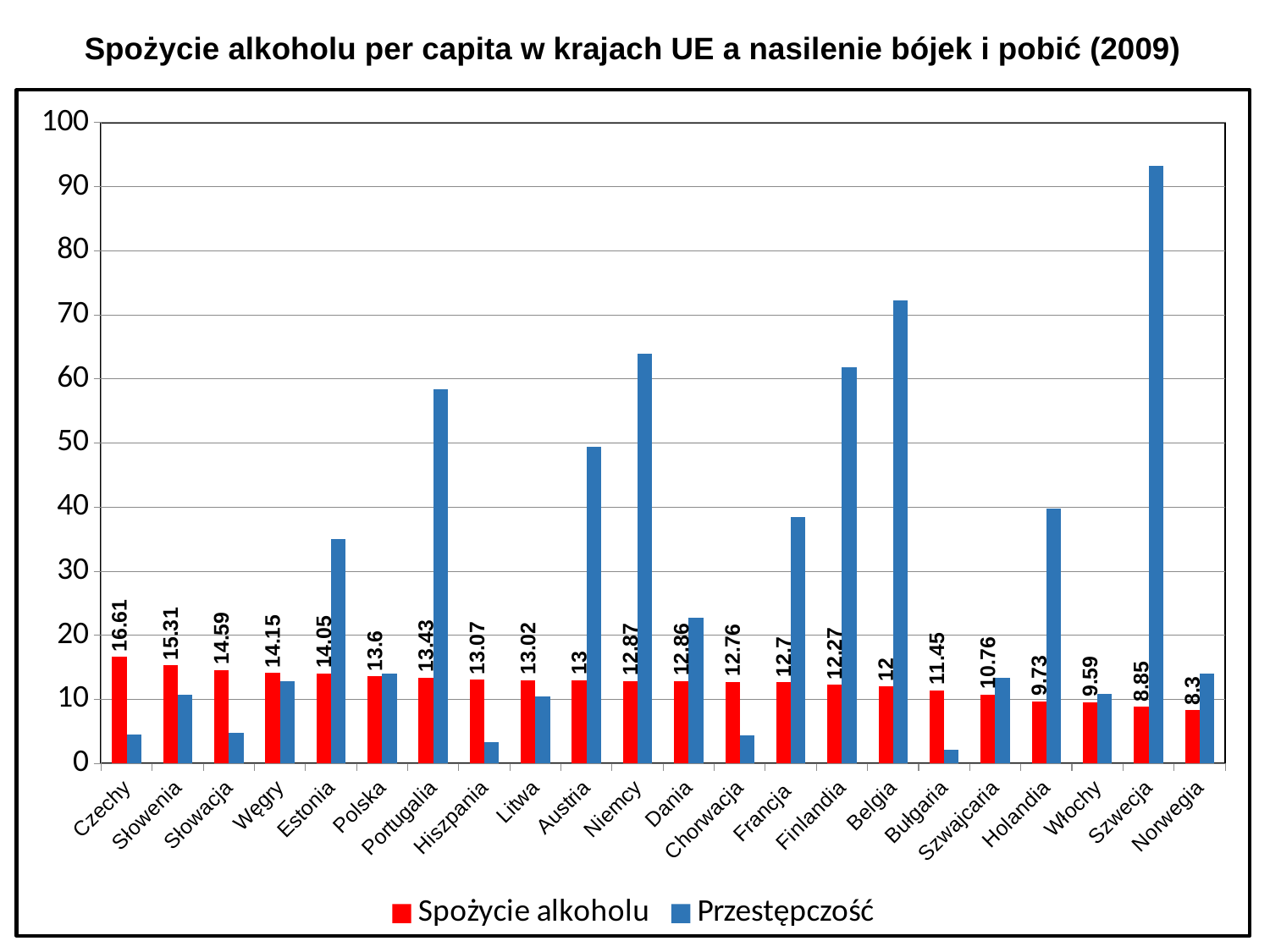
Which has a higher Spożycie alkoholu value, Słowenia or Węgry? Słowenia How many series does the legend list? 2 Which country has the highest Spożycie alkoholu value? Czechy What is the difference between the Spożycie alkoholu values for Czechy and Norwegia? 8.31 Which country has the lowest Spożycie alkoholu value? Norwegia What is the Spożycie alkoholu value for Czechy? 16.61 Is the Przestępczość value for Szwecja greater or less than 90? greater Which country has the highest Przestępczość value? Szwecja How many countries are shown on the x axis? 22 What type of chart is shown on the slide? Bar chart What is the Spożycie alkoholu value for Polska? 13.6 Is the Przestępczość value for Czechy greater or less than 10? less